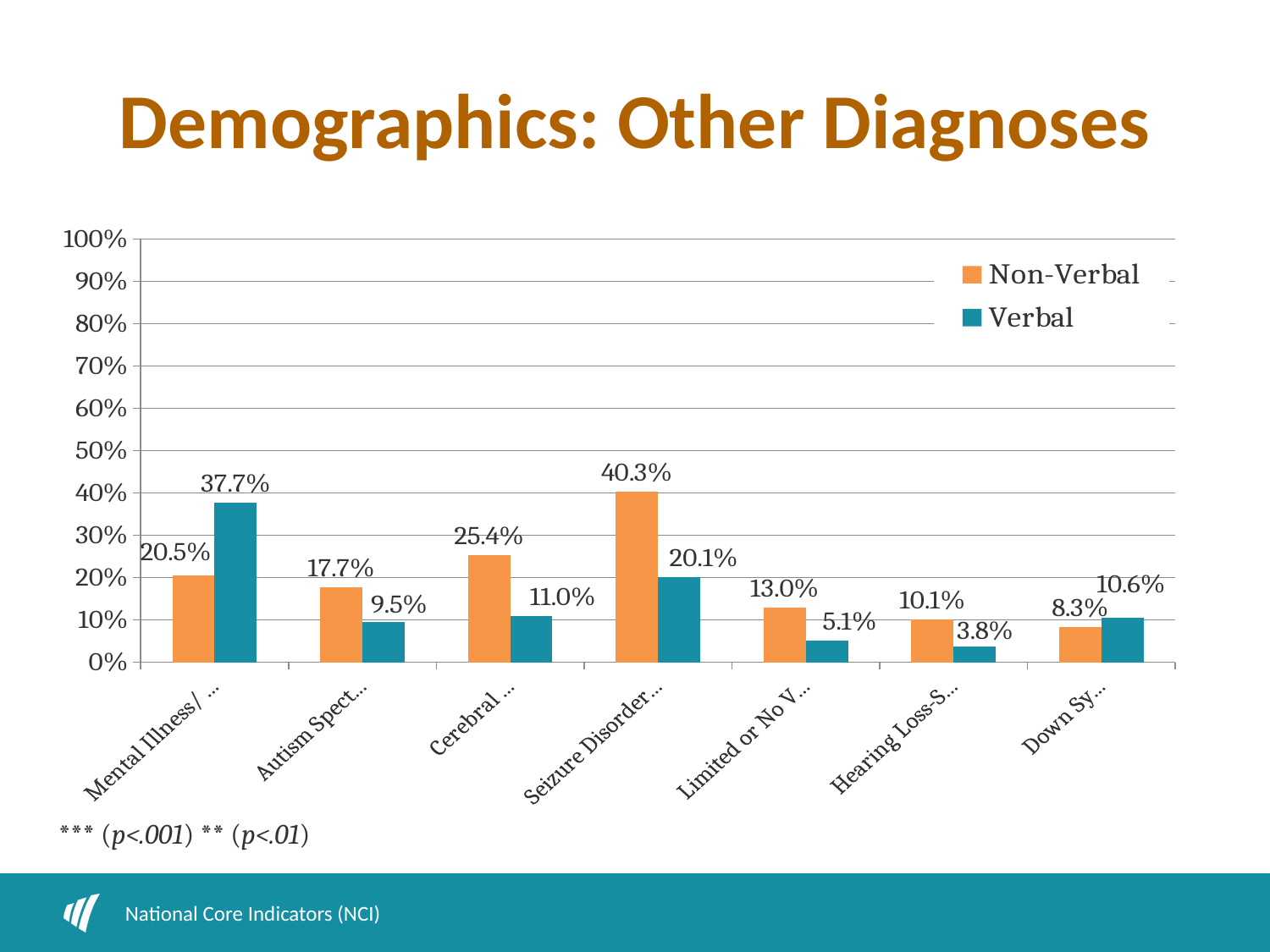
What is the difference between the Non-Verbal and Verbal values for the Seizure Disorder category? 20.2% How many series does the legend list? 2 How many categories are shown on the x axis? 7 For the category labelled Down Sy..., which is larger, the Non-Verbal or the Verbal value? Verbal Which category has the highest Non-Verbal value? Seizure Disorder What is the Non-Verbal value for the category labelled Cerebral? 25.4% Which category has the lowest Verbal value? Hearing Loss Is the Verbal value for the category labelled Mental Illness greater or less than 30%? greater What is the Non-Verbal value for the Seizure Disorder category? 40.3% What is the Verbal value for the category labelled Mental Illness? 37.7% What type of chart is shown on the slide? Bar chart What is the Verbal value for the category labelled Hearing Loss? 3.8%